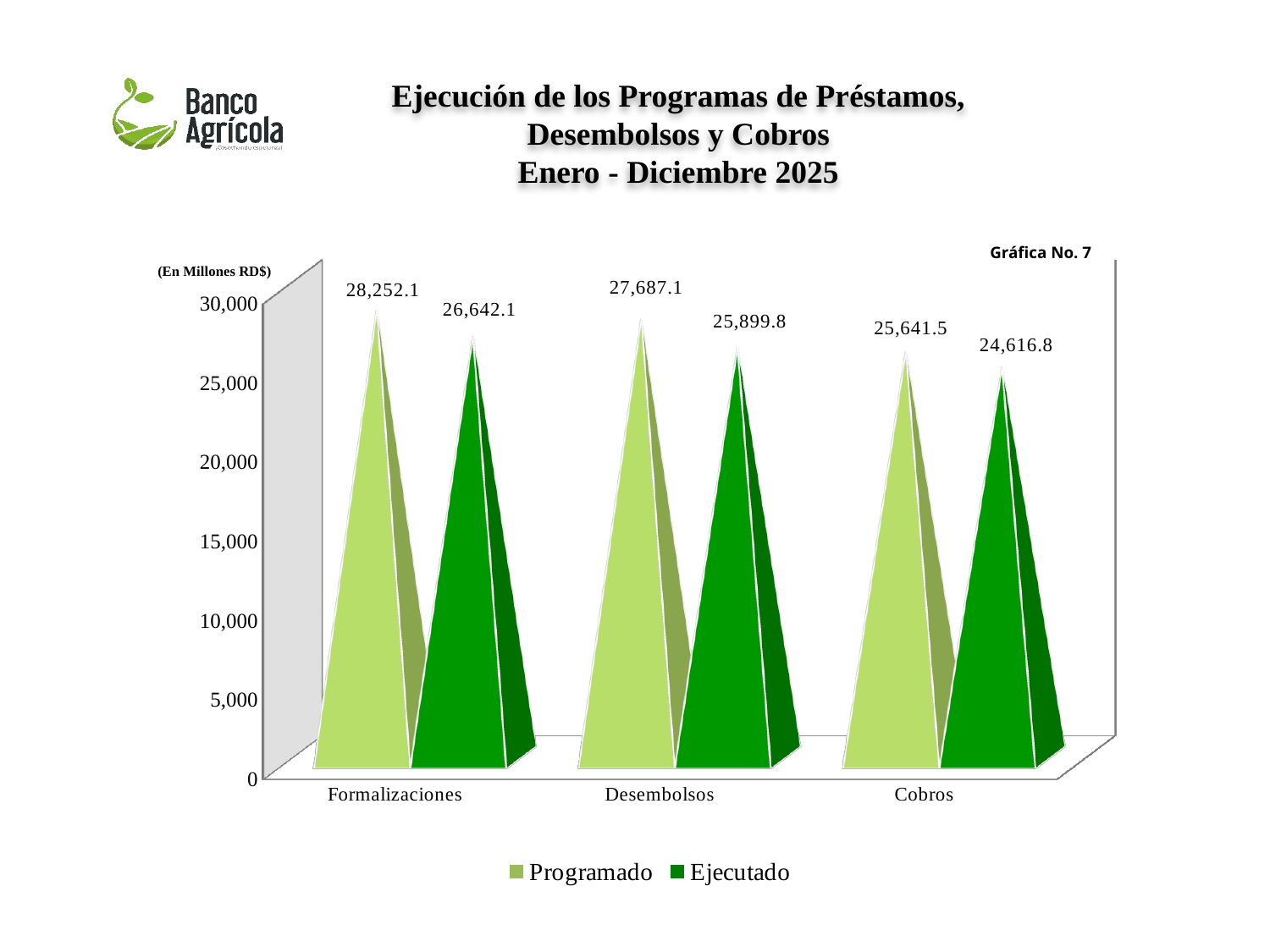
How many series does the legend list? 2 Which category has the lowest Ejecutado value? Cobros What is the Ejecutado value for Desembolsos? 25,899.8 What is the Programado value for Cobros? 25,641.5 Which is larger: the Ejecutado value for Formalizaciones or the Programado value for Cobros? Ejecutado value for Formalizaciones What is the Programado value for Formalizaciones? 28,252.1 What is the difference between the Programado and Ejecutado values for Desembolsos? 1,787.3 What is the Ejecutado value for Cobros? 24,616.8 Which category has the highest Programado value? Formalizaciones How many categories are shown on the x axis? 3 What unit is stated for the values in the chart? En Millones RD$ What is the difference between the Programado and Ejecutado values for Formalizaciones? 1,610.0